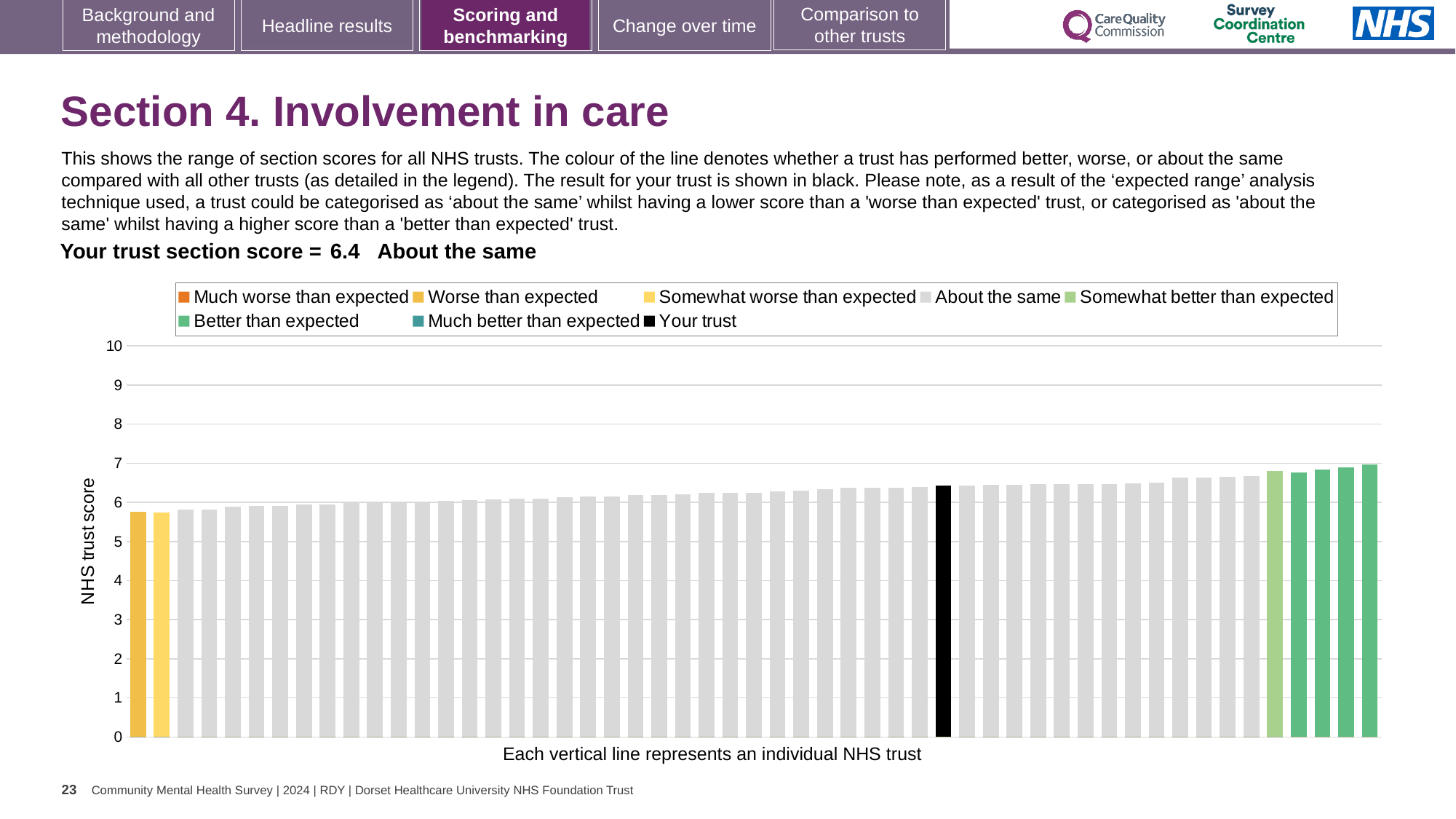
Is the value for the rightmost bar greater or less than 6? greater Is the value for the black 'Your trust' bar greater or less than 6? greater How many bars are coloured as 'Worse than expected' (yellow)? 1 How many entries does the chart legend list? 8 What category is your trust placed in according to the text above the chart? About the same What is the label on the vertical axis of the chart? NHS trust score What kind of chart is shown on the slide? bar chart What is the section score for your trust shown on the slide? 6.4 Do the bar values rise or fall from left to right along the x axis? rise Is the value for the leftmost bar greater or less than 6? less How many bars are coloured as 'Better than expected' (green)? 4 Which is larger, the value for the black 'Your trust' bar or the value for the leftmost bar? Your trust